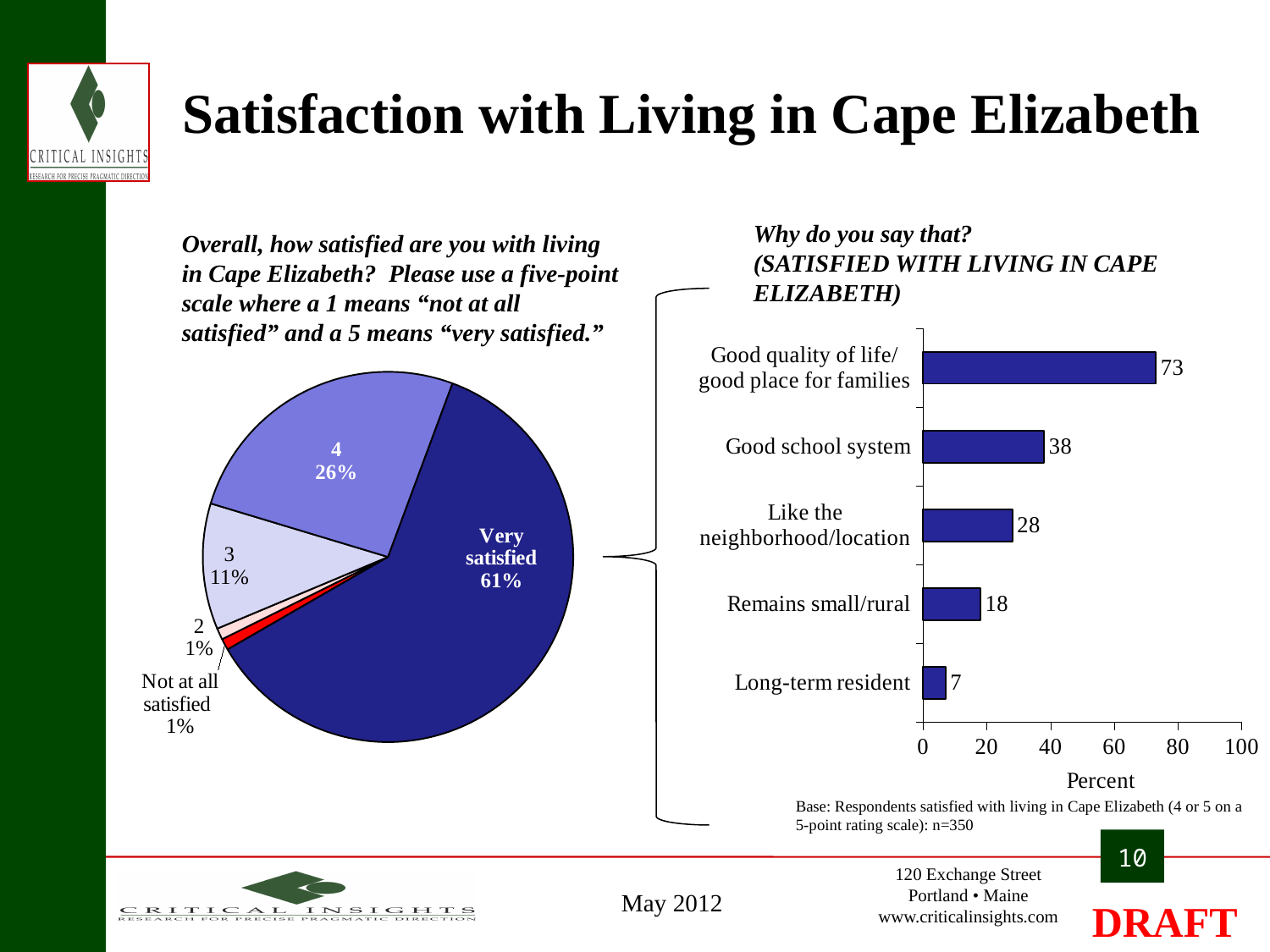
In the pie chart on the left, how many slices are labeled? 5 In the pie chart on the left, what percentage gave a rating of 4? 26% In the pie chart on the left, what share of respondents are "Very satisfied"? 61% In the bar chart on the right, what is the value for "Good school system"? 38 In the bar chart on the right, what is the value for "Remains small/rural"? 18 In the pie chart on the left, which category has the largest slice? Very satisfied In the bar chart on the right, which is larger: "Like the neighborhood/location" or "Remains small/rural"? Like the neighborhood/location In the bar chart on the right, what is the difference between "Good quality of life/ good place for families" and "Good school system"? 35 In the pie chart on the left, what percentage gave a rating of 3? 11% What type of chart is shown on the right side of the slide? Bar chart In the bar chart on the right, which reason has the highest value? Good quality of life/ good place for families In the bar chart on the right, which reason has the lowest value? Long-term resident